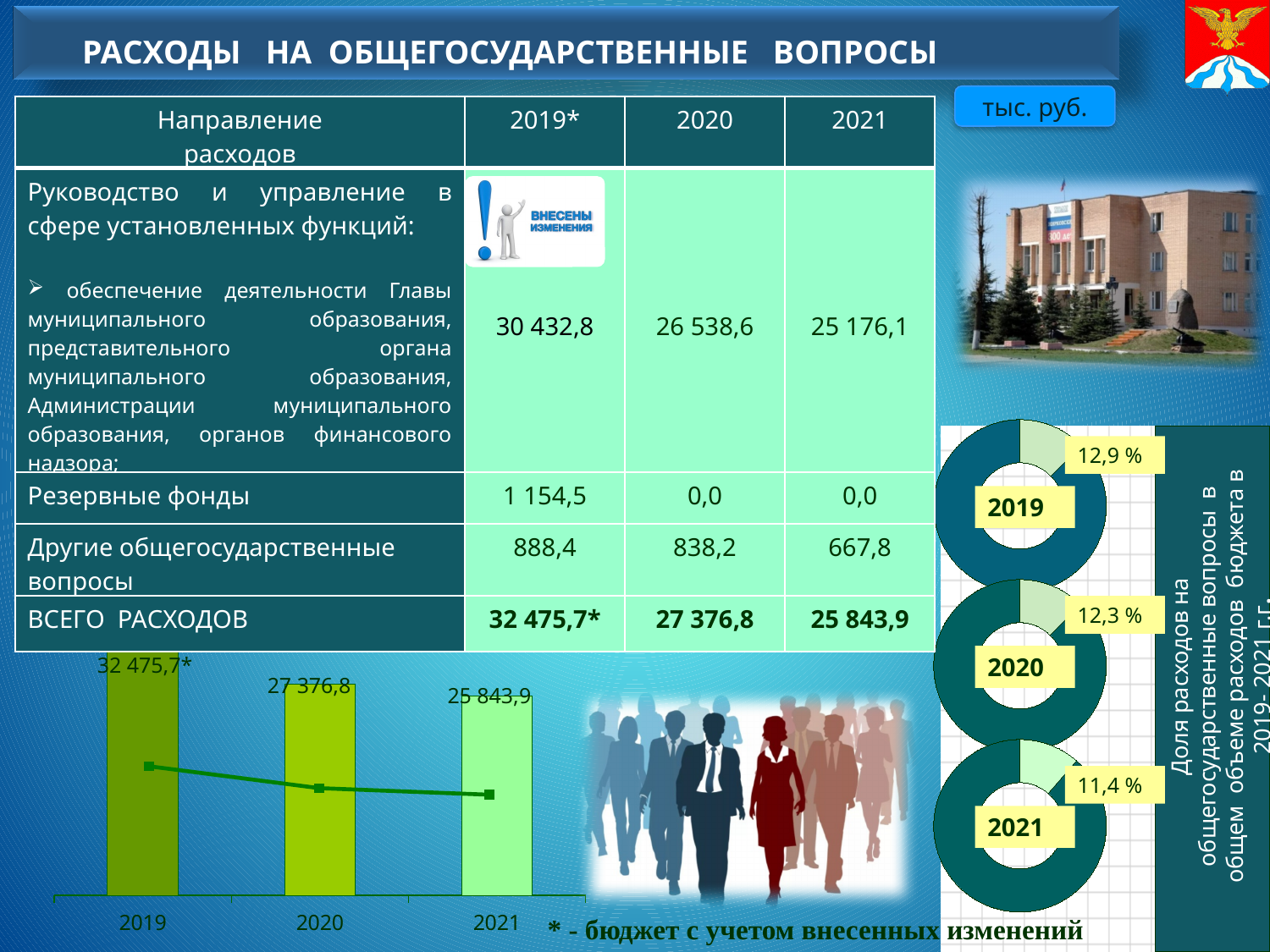
In the bar chart at the bottom left, which year has the highest value? 2019 In the bar chart at the bottom left, what is the difference between the values for 2020 and 2021? 1 532,9 In the bar chart at the bottom left, which year has the lowest value? 2021 How many bars are in the bar chart at the bottom left? 3 What kind of chart is shown at the bottom left of the slide? bar chart In the donut charts on the right, what share is shown for 2021? 11,4 % In the bar chart at the bottom left, do the values rise or fall from 2019 to 2021? fall In the bar chart at the bottom left, what is the value for 2020? 27 376,8 In the bar chart at the bottom left, what is the value labelled for 2019? 32 475,7* In the donut charts on the right, is the share for 2020 larger or smaller than the share for 2021? larger In the bar chart at the bottom left, what is the value for 2021? 25 843,9 In the donut charts on the right, what share is shown for 2019? 12,9 %